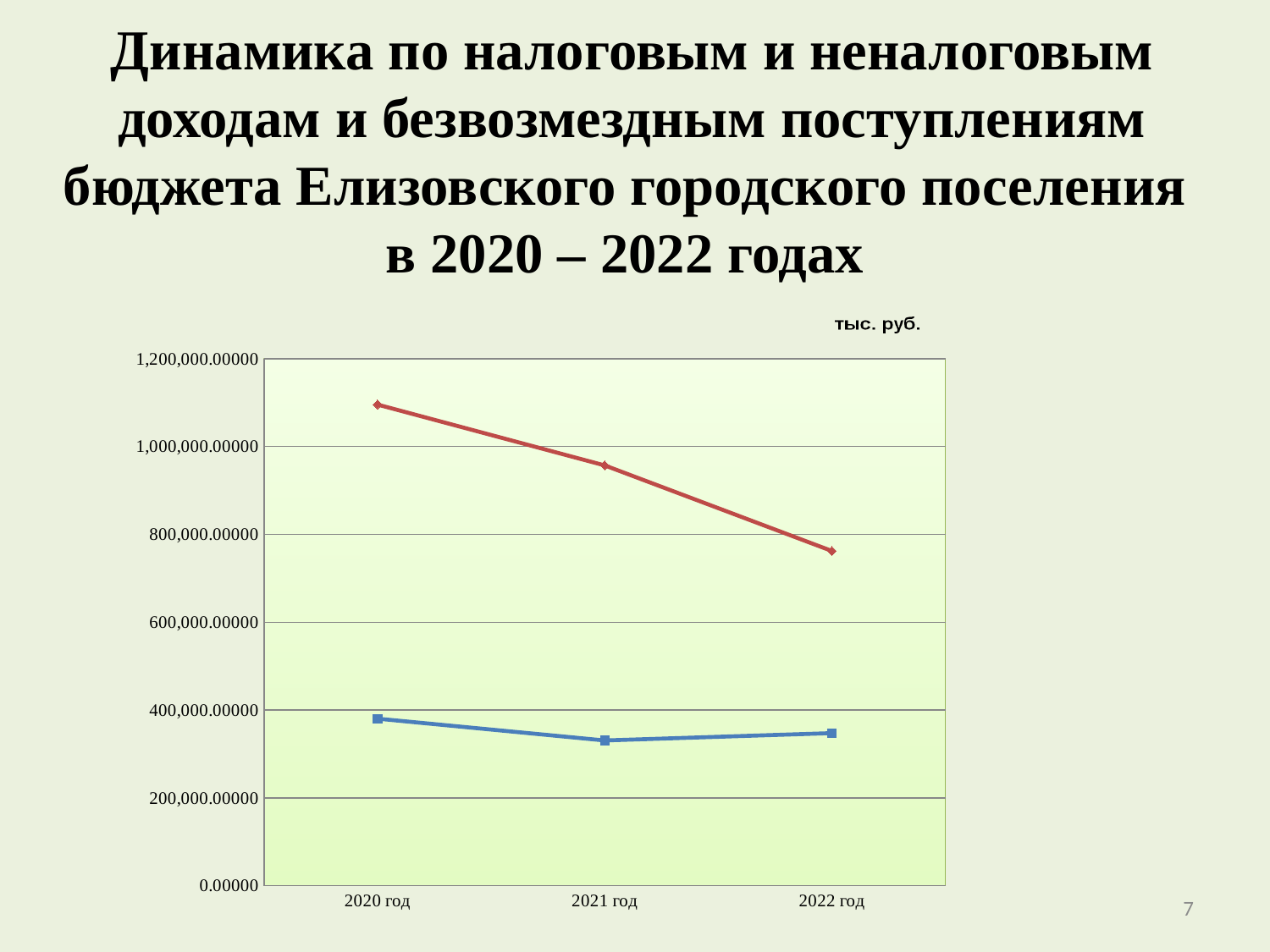
What unit is indicated above the chart? тыс. руб. Is the value of the red line for 2020 год greater or less than 1,000,000.00000? greater In which year is the red line at its lowest? 2022 год Is the value of the blue line for 2020 год greater or less than 400,000.00000? less Which line has the larger value in 2021 год, the red line or the blue line? the red line Is the value of the red line for 2022 год greater or less than 800,000.00000? less How many lines are plotted on the chart? 2 In which year is the red line at its highest? 2020 год How many years are shown on the x axis of the chart? 3 What kind of chart is shown on the slide? line chart Does the red line rise or fall from 2020 год to 2022 год? fall In which year is the blue line at its highest? 2020 год